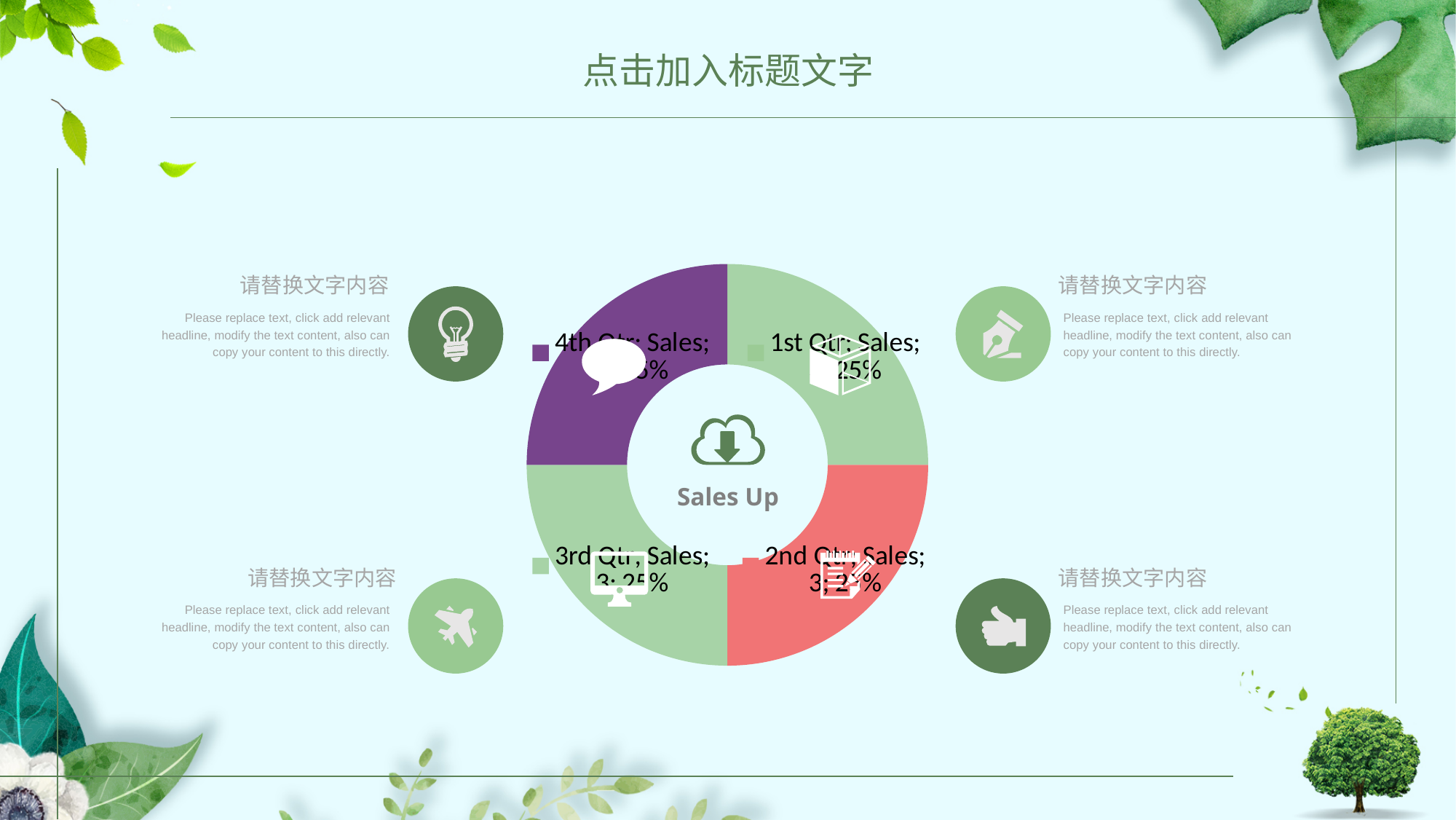
What share of the chart does the 1st Qtr slice represent? 25% What is the value shown for 1st Qtr? 25% What kind of chart is shown on the slide? doughnut chart How many categories (slices) does the chart have? 4 Which quarter's slice is coloured purple? 4th Qtr What text is displayed in the centre of the doughnut chart? Sales Up What series name appears in the data labels of the chart? Sales Which quarter's slice is coloured red? 2nd Qtr What is the value shown for 3rd Qtr? 25%